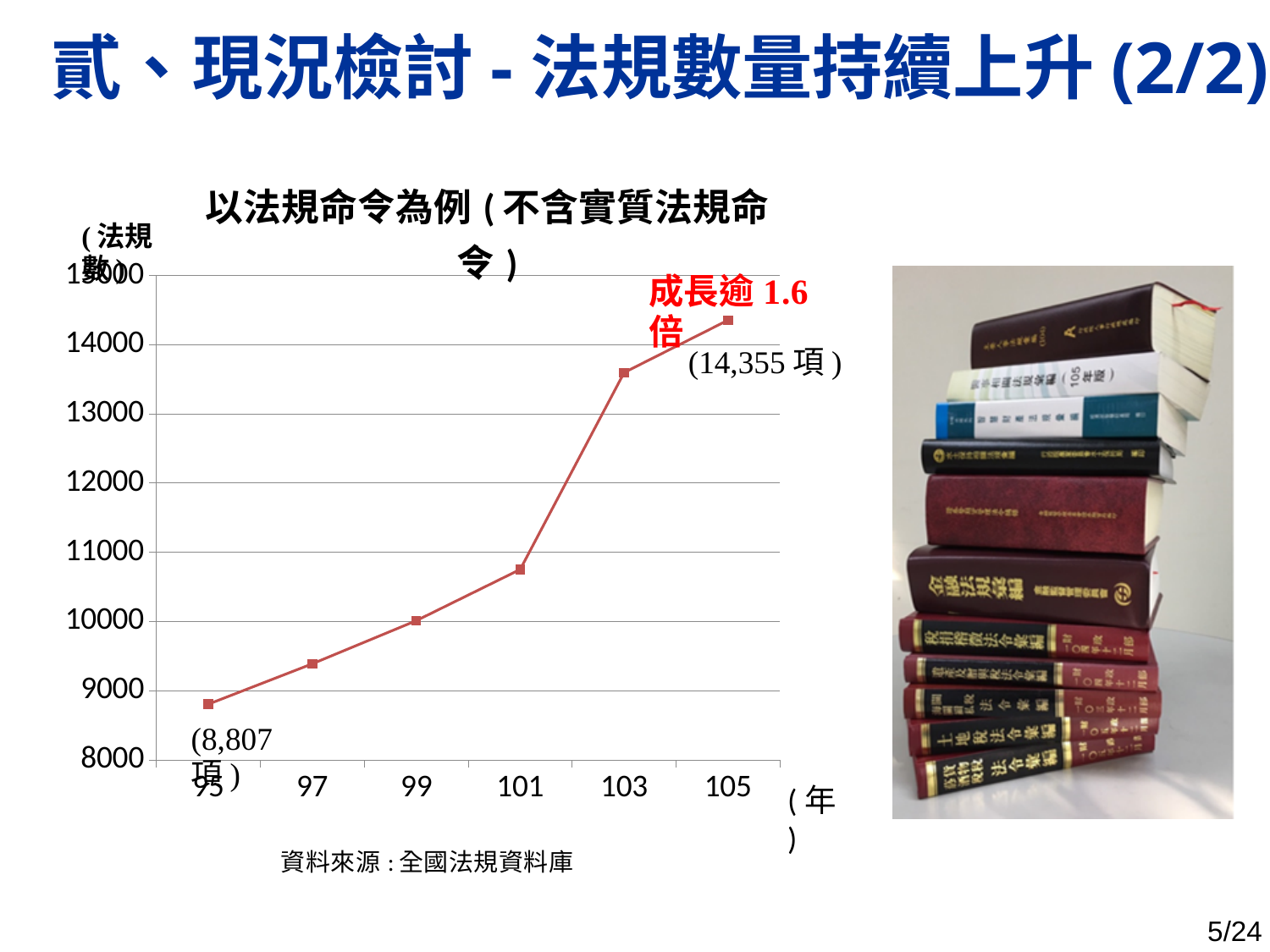
What is the difference between the values for year 105 and year 95? 5,548 What kind of chart is shown on the slide? line chart Is the value for year 97 greater or less than 10000? less What is the value for year 105 in the line chart? 14,355 項 Which year has the highest value in the chart? 105 Is the value for year 103 greater or less than 13000? greater How many data points are plotted on the line? 6 Do the values rise or fall from year 95 to year 105? rise Which year has the larger value, 99 or 103? 103 What is the value for year 95 in the line chart? 8,807 項 Which year has the lowest value in the chart? 95 What is the data source cited below the chart? 全國法規資料庫